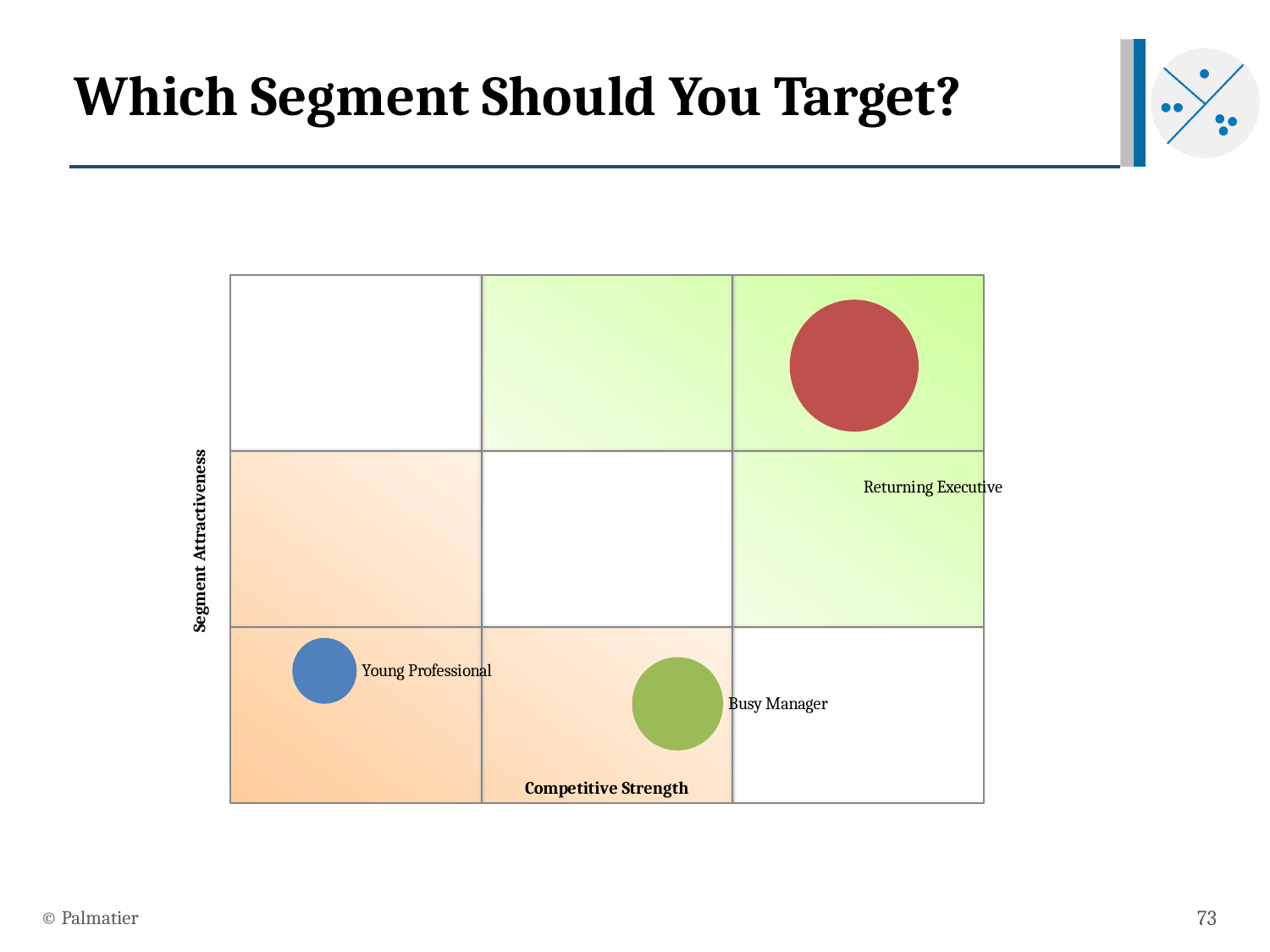
Which segment has greater Competitive Strength, Young Professional or Busy Manager? Busy Manager What kind of chart is shown on the slide? Bubble chart Which segment is plotted highest on the Segment Attractiveness axis? Returning Executive Which segment's bubble is larger, Busy Manager or Young Professional? Busy Manager What is the label of the vertical axis of the chart? Segment Attractiveness Which segment has the largest bubble on the chart? Returning Executive Which segment is plotted furthest left on the Competitive Strength axis? Young Professional How many segments (bubbles) are plotted on the chart? 3 Which segment has the smallest bubble on the chart? Young Professional Which segment has greater Segment Attractiveness, Returning Executive or Busy Manager? Returning Executive What is the label of the horizontal axis of the chart? Competitive Strength